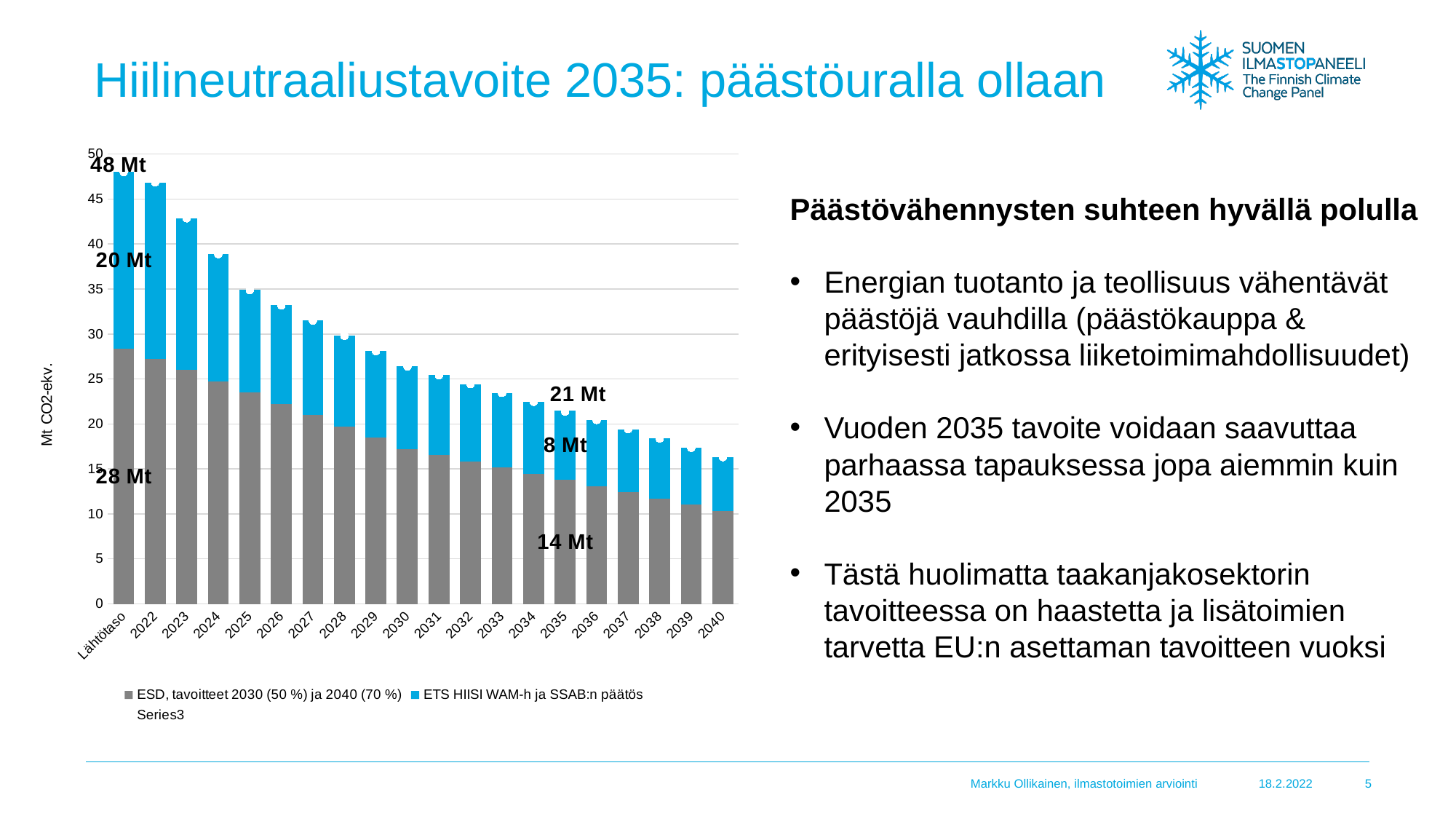
Is the total value for 2040 greater or less than 20? less Do the total bar heights rise or fall from Lähtötaso to 2040? fall By how much does the labelled total fall from Lähtötaso (48 Mt) to 2035 (21 Mt)? 27 Mt How many entries does the chart legend list? 3 What is the ESD (grey) value labelled for the Lähtötaso bar? 28 Mt What is the ESD (grey) value labelled for 2035? 14 Mt Which category has the highest total bar? Lähtötaso What is the ETS (blue) value labelled for the Lähtötaso bar? 20 Mt Which year has the lowest total bar? 2040 What is the total emissions value labelled for the Lähtötaso bar? 48 Mt What type of chart is shown on the slide? stacked bar chart What is the total emissions value labelled for the 2035 bar? 21 Mt